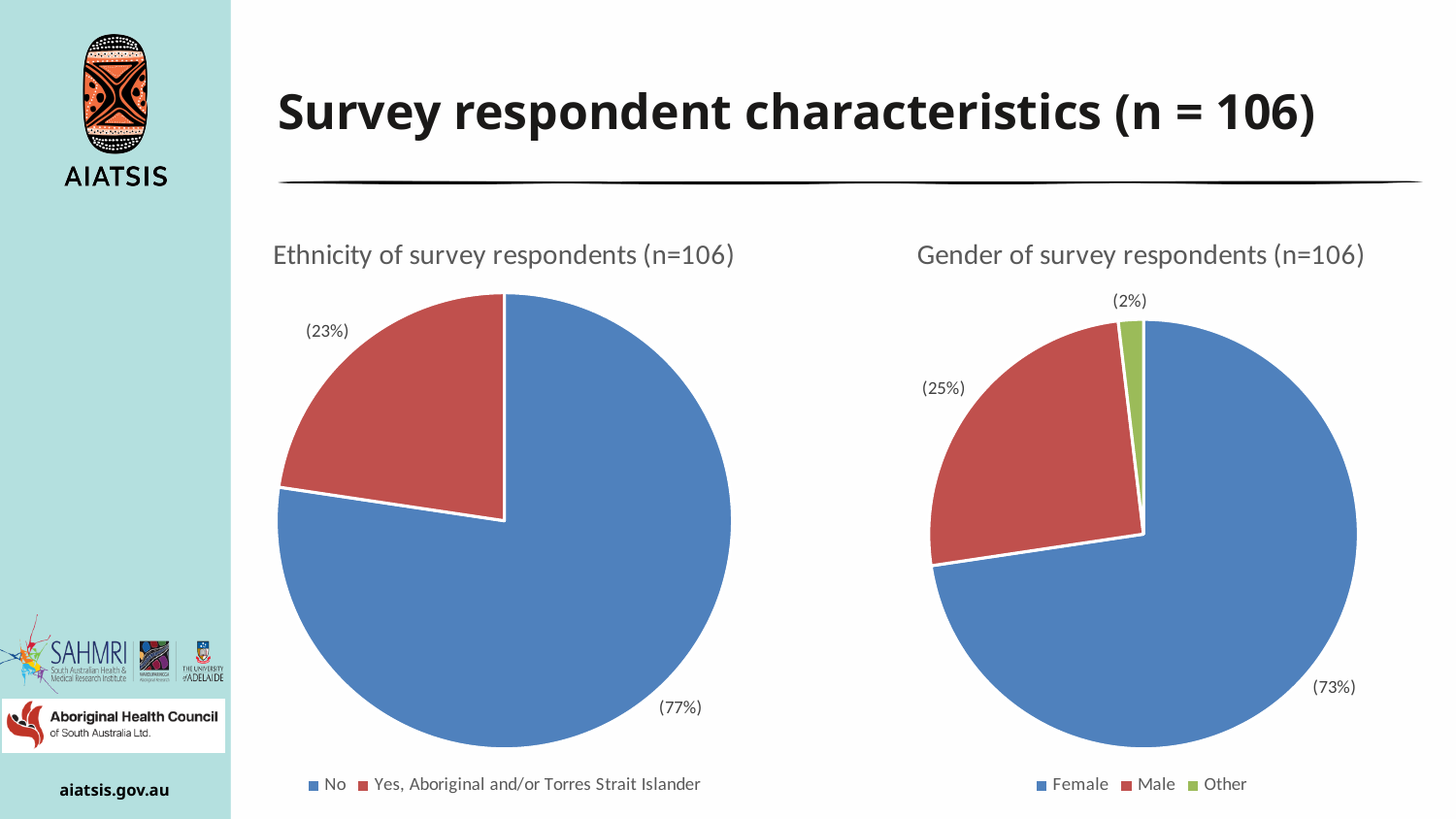
In the 'Gender of survey respondents (n=106)' chart, which category has the smallest share? Other In the 'Gender of survey respondents (n=106)' chart, what is the difference in percentage points between the Female and Male shares? 48 What type of chart is the 'Ethnicity of survey respondents (n=106)' chart? Pie chart In the 'Gender of survey respondents (n=106)' chart, what share of respondents are Male? 25% In the 'Ethnicity of survey respondents (n=106)' chart, what share of respondents answered 'Yes, Aboriginal and/or Torres Strait Islander'? 23% In the 'Ethnicity of survey respondents (n=106)' chart, what share of respondents answered 'No'? 77% In the 'Gender of survey respondents (n=106)' chart, which category has the largest share? Female How many categories does the legend of the 'Gender of survey respondents (n=106)' chart list? 3 In the 'Ethnicity of survey respondents (n=106)' chart, which category has the larger share? No In the 'Ethnicity of survey respondents (n=106)' chart, what is the difference in percentage points between the 'No' and 'Yes' shares? 54